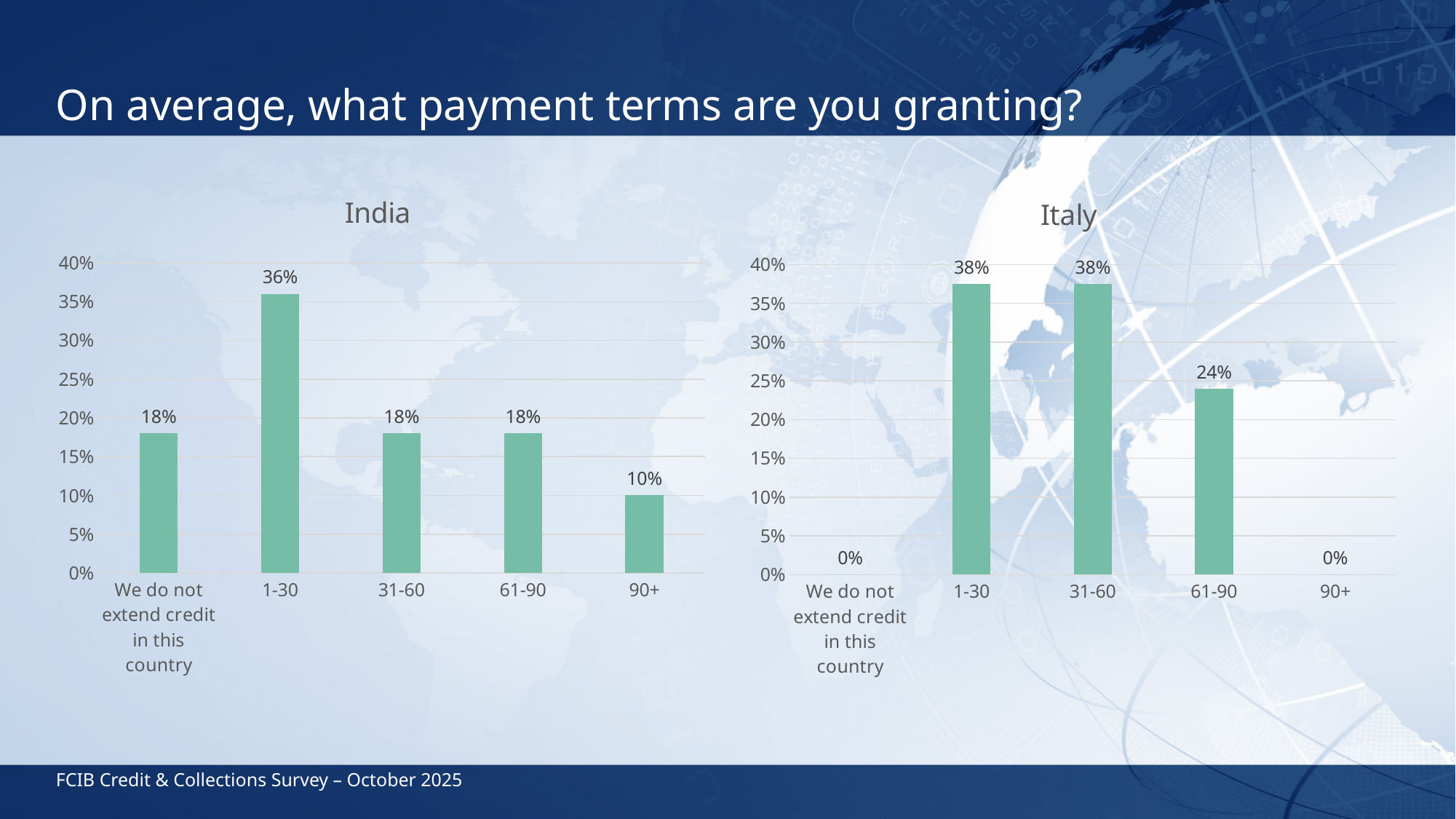
In the India chart, what is the value for 90+? 10% Which is larger: the value for 1-30 in the India chart or the value for 1-30 in the Italy chart? Italy In the Italy chart, what is the value for 'We do not extend credit in this country'? 0% In the India chart, what is the difference between the values for 1-30 and 90+? 26% In the India chart, what is the value for 1-30? 36% What is the title of the chart on the right side of the slide? Italy In the India chart, which category has the highest value? 1-30 In the India chart, which category has the lowest value? 90+ In the Italy chart, what is the difference between the values for 31-60 and 61-90? 14% How many categories are shown on the x axis of the Italy chart? 5 What kind of chart is the India chart? Bar chart In the Italy chart, what is the value for 61-90? 24%